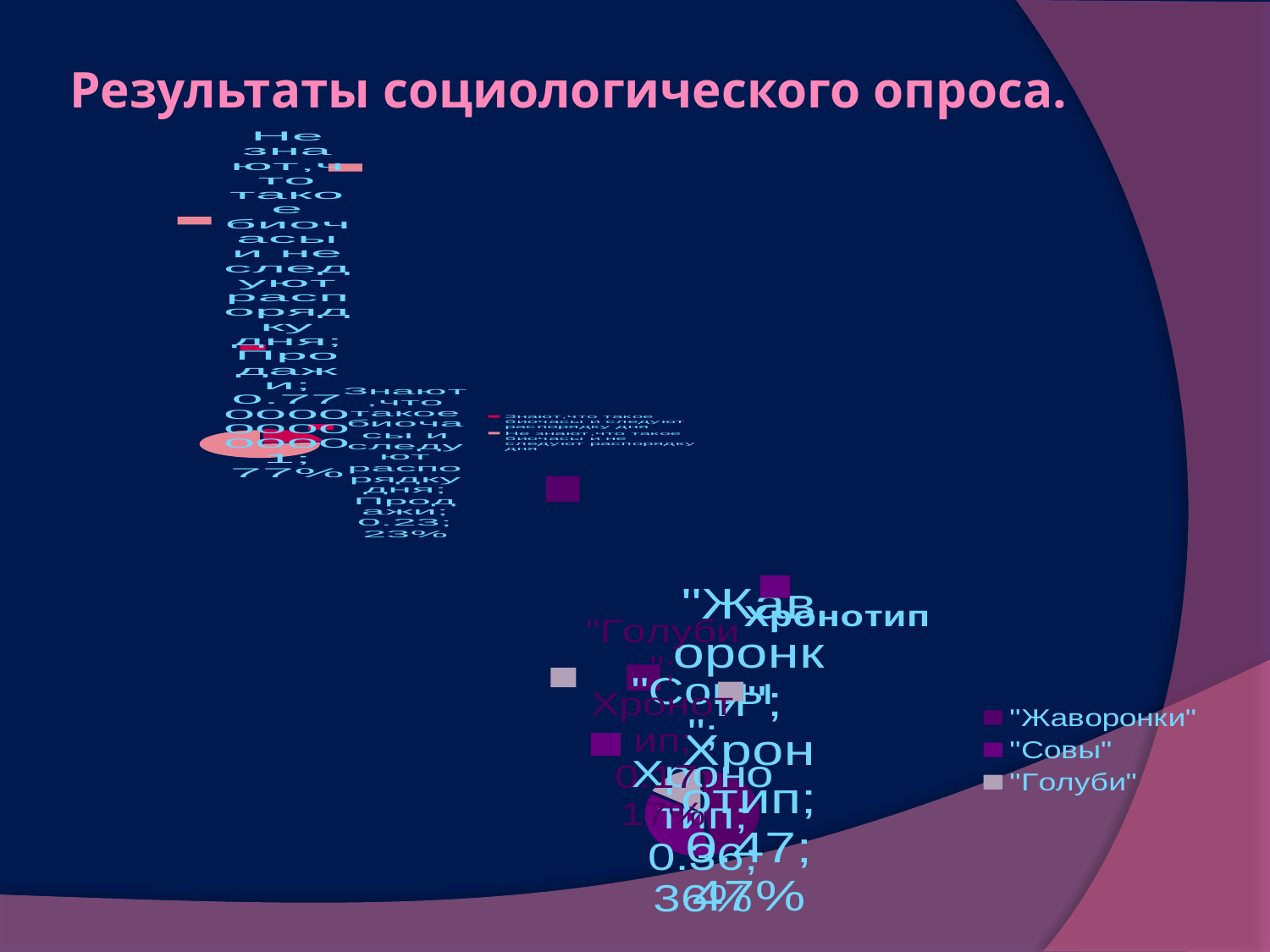
In the 'Хронотип' chart, which category has the largest share? Жаворонки In the top-left pie chart, what share is shown for the slice 'Не знают, что такое биочасы и не следуют распорядку дня'? 77% What is the title of the bottom-right chart? Хронотип How many entries does the legend of the 'Хронотип' chart list? 3 In the top-left pie chart, what share is shown for the slice 'Знают, что такое биочасы и следуют распорядку дня'? 23% In the top-left pie chart, which slice is larger: 'Знают, что такое биочасы и следуют распорядку дня' or 'Не знают, что такое биочасы и не следуют распорядку дня'? Не знают, что такое биочасы и не следуют распорядку дня In the 'Хронотип' chart, what share is shown for 'Жаворонки'? 47% How many entries does the legend of the top-left chart list? 2 What kind of chart is the 'Хронотип' chart? pie chart In the 'Хронотип' chart, what is the difference in percentage points between the shares of 'Жаворонки' and 'Совы'? 11 What kind of chart is the top-left chart on the slide? pie chart